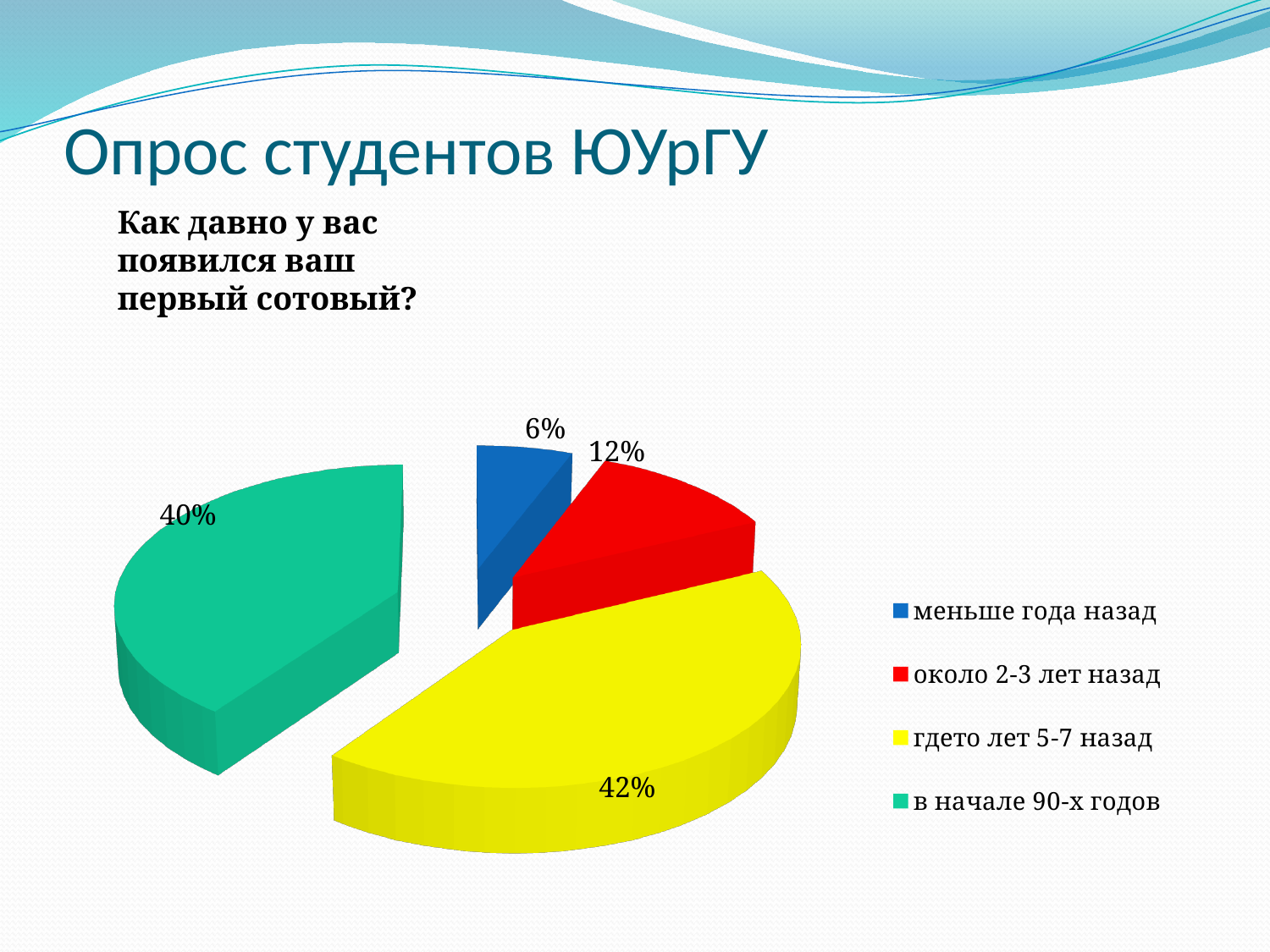
What is the difference in percentage points between "около 2-3 лет назад" and "меньше года назад"? 6 What kind of chart is shown on the slide? pie chart What share of respondents answered "в начале 90-х годов"? 40% Which answer option has the largest share of the pie? гдето лет 5-7 назад How many slices does the pie chart have? 4 Which is larger: the share for "около 2-3 лет назад" or the share for "в начале 90-х годов"? в начале 90-х годов Which colour represents "в начале 90-х годов" in the legend? green Which answer option has the smallest share of the pie? меньше года назад What share of respondents answered "меньше года назад"? 6% What share of respondents answered "гдето лет 5-7 назад"? 42% What share of respondents answered "около 2-3 лет назад"? 12% What question is the pie chart answering, as written on the slide? Как давно у вас появился ваш первый сотовый?